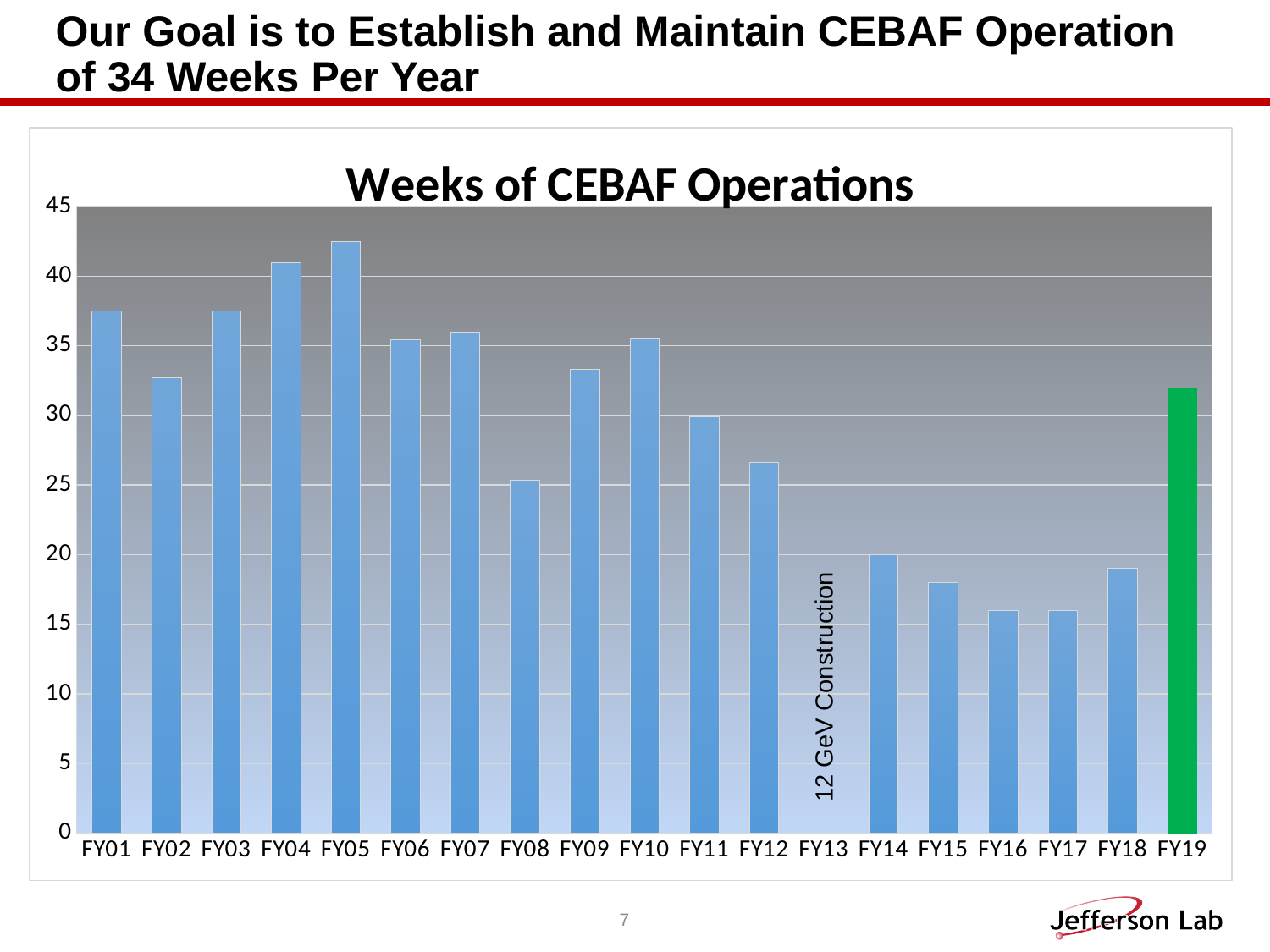
Which is larger, the value for FY19 or the value for FY18? FY19 Which is larger, the value for FY04 or the value for FY09? FY04 What text appears in place of a bar for FY13? 12 GeV Construction What kind of chart is shown on the slide? bar chart What is the title of the chart? Weeks of CEBAF Operations Is the value for FY15 greater or less than 20? less Is the value for FY05 greater or less than 40? greater Do the values rise or fall from FY05 to FY08? fall Is the value for FY19 greater or less than 30? greater Which fiscal year has the highest number of weeks of CEBAF operations? FY05 How many fiscal year categories are shown on the x axis? 19